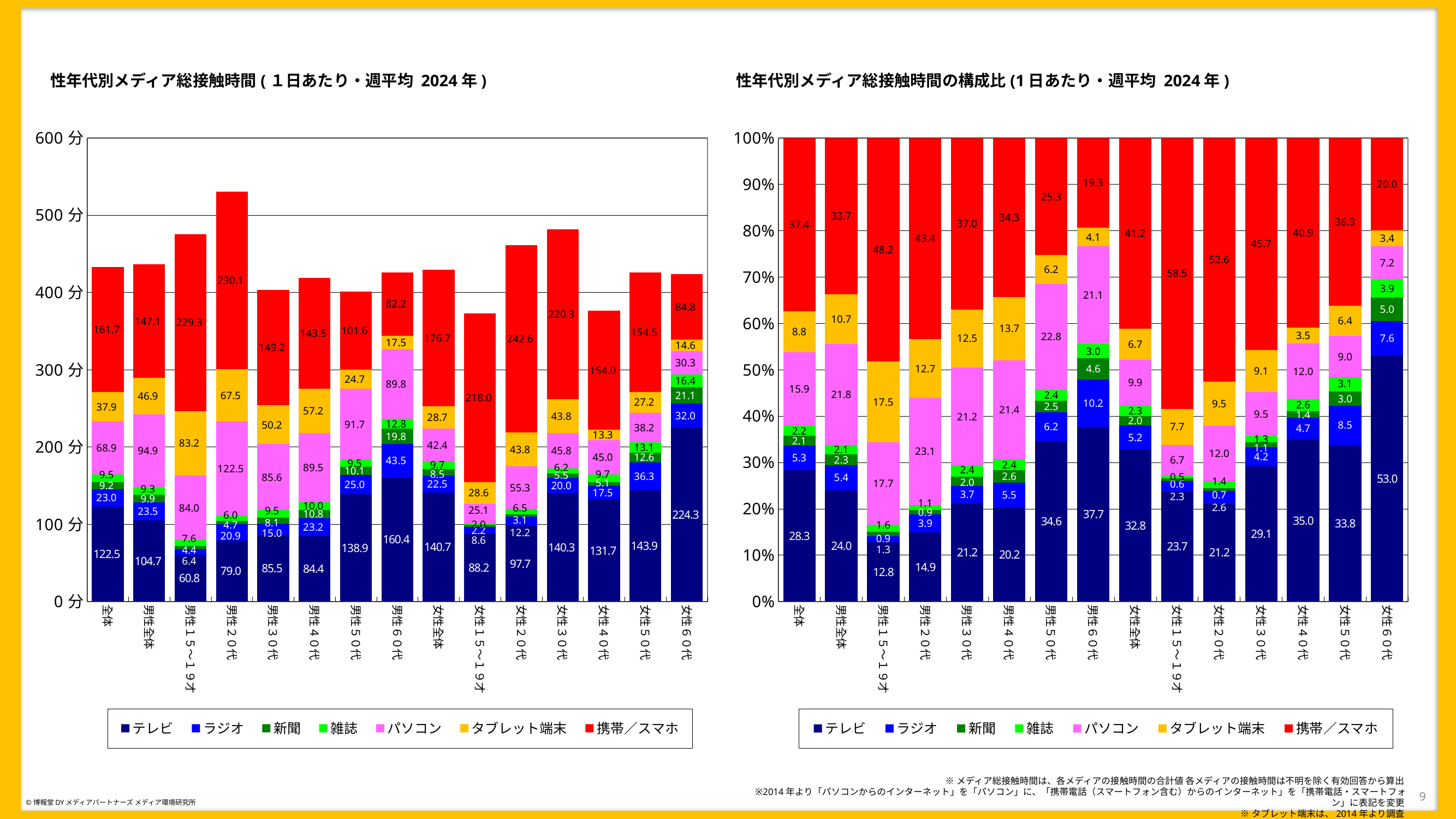
In the left chart (性年代別メディア総接触時間), what is the total of the stacked bar for 全体? 432.7 In the left chart (性年代別メディア総接触時間), which is larger, the パソコン value for 男性２０代 or for 女性２０代? 男性２０代 In the right chart (性年代別メディア総接触時間の構成比), which category has the lowest 携帯／スマホ share? 男性６０代 In the left chart (性年代別メディア総接触時間), which category has the highest 携帯／スマホ value? 女性２０代 How many categories are shown on the x axis of the left chart (性年代別メディア総接触時間)? 15 How many series does the legend of the right chart (性年代別メディア総接触時間の構成比) list? 7 In the left chart (性年代別メディア総接触時間), what is the difference between the テレビ values for 女性６０代 and 男性６０代? 63.9 In the left chart (性年代別メディア総接触時間), is the total for 男性２０代 greater or less than 500 分? greater What kind of chart is the left chart (性年代別メディア総接触時間)? stacked bar chart In the left chart (性年代別メディア総接触時間), what is the 携帯／スマホ value for 男性２０代? 230.1 In the left chart (性年代別メディア総接触時間), what is the テレビ value for 女性６０代? 224.3 In the right chart (性年代別メディア総接触時間の構成比), what is the 携帯／スマホ share for 女性１５～１９才? 58.5